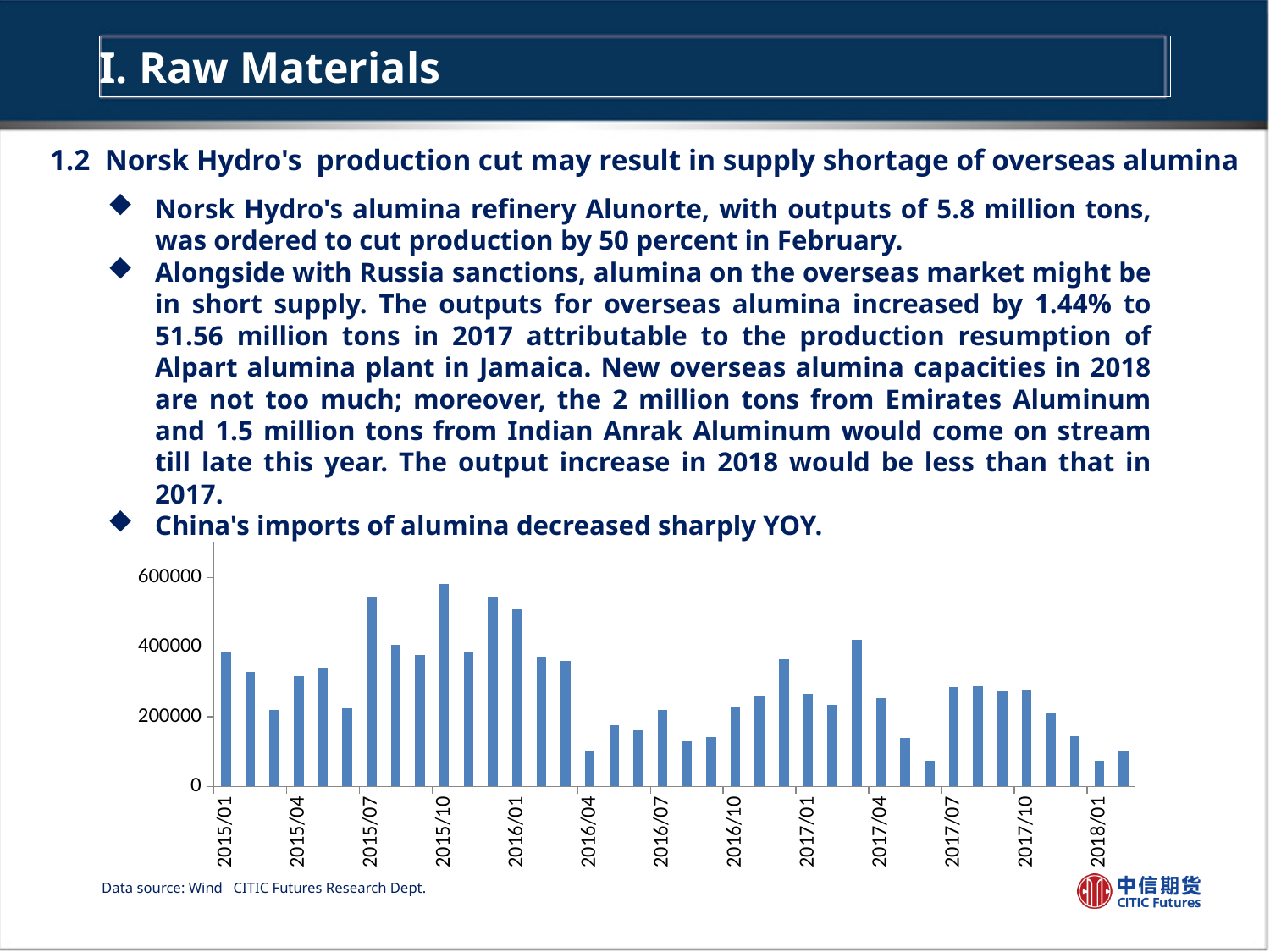
Is the value for 2015/07 greater or less than 400000? greater Is the value for 2017/01 greater or less than 200000? greater Which month has the highest value in the chart? 2015/10 What is the highest value shown on the chart's vertical axis? 600000 Is the value for 2015/10 greater or less than 400000? greater Overall, do the values rise or fall from 2015 to 2018 along the x axis? fall What kind of chart is shown on the slide? bar chart Which is larger, the value for 2015/10 or the value for 2018/01? 2015/10 Which is larger, the value for 2016/04 or the value for 2017/07? 2017/07